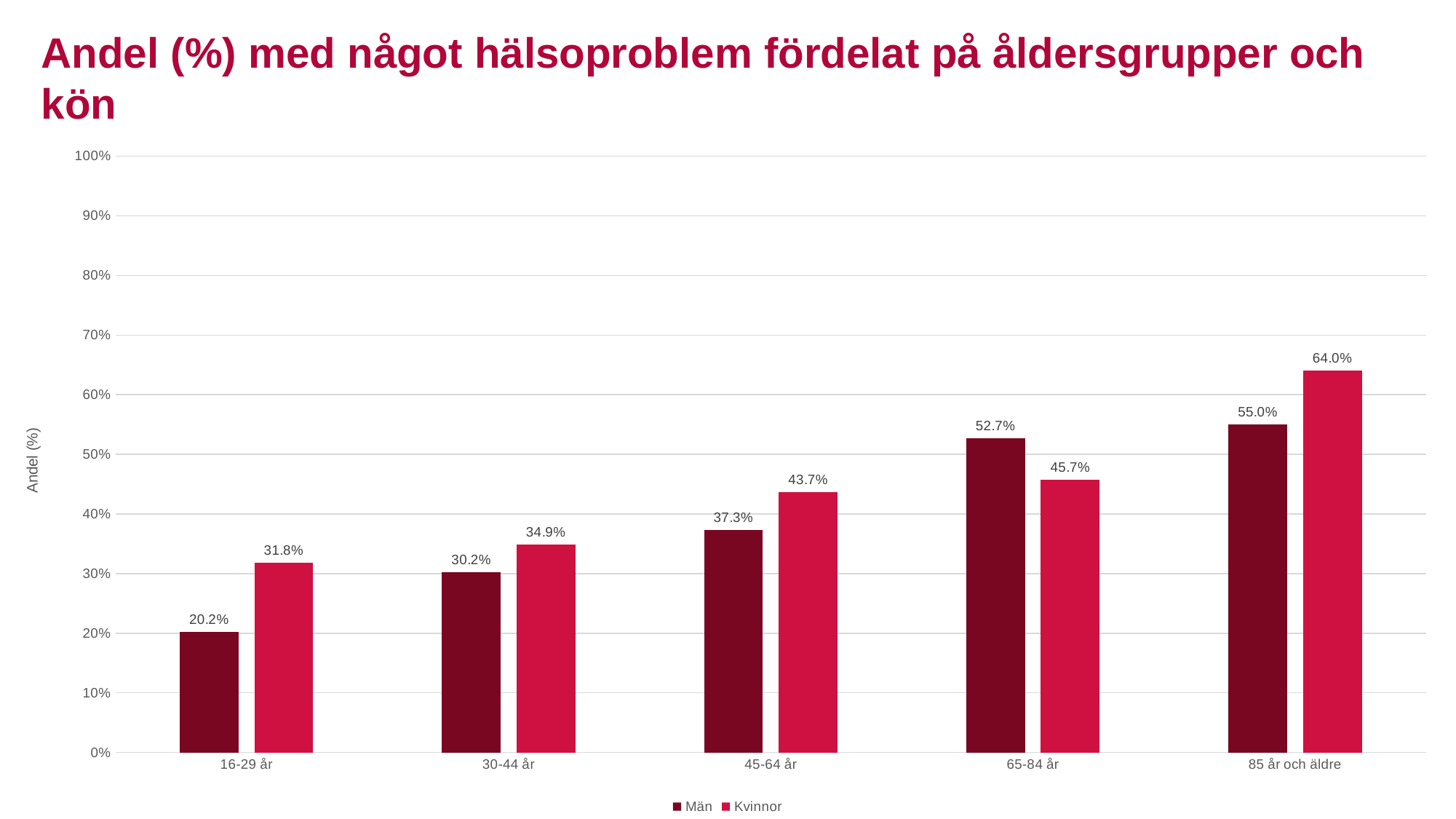
How many series does the legend list? 2 What is the value for Kvinnor in the 45-64 år age group? 43.7% What is the value for Män in the 16-29 år age group? 20.2% In the 65-84 år age group, which is larger, Män or Kvinnor? Män What is the value for Män in the 65-84 år age group? 52.7% How many age groups are shown on the x axis? 5 Is the value for Kvinnor in the 30-44 år age group greater or less than 30%? greater What is the difference between Kvinnor and Män in the 85 år och äldre age group? 9.0% What kind of chart is shown on the slide? Bar chart Which age group has the highest value for Kvinnor? 85 år och äldre Which age group has the lowest value for Män? 16-29 år Do the values for Kvinnor rise or fall from the youngest to the oldest age group? Rise